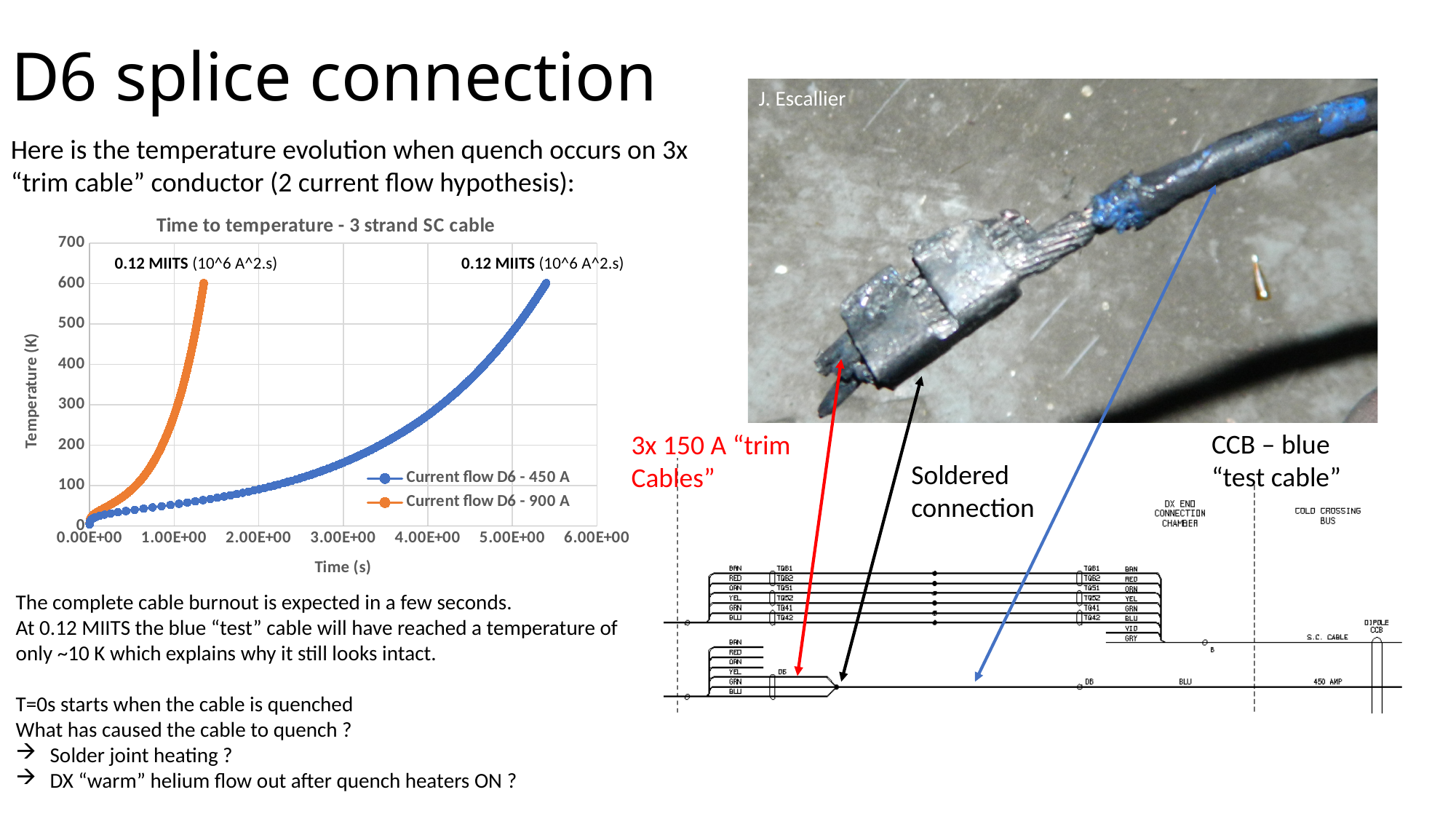
What is the title of the chart? Time to temperature - 3 strand SC cable At a time of 1.00E+00 s, is the temperature for Current flow D6 - 450 A greater or less than 100 K? less At a time of 1.00E+00 s, is the temperature for Current flow D6 - 900 A greater or less than 200 K? greater What are the two series named in the chart legend? Current flow D6 - 450 A and Current flow D6 - 900 A At a time of 5.00E+00 s, is the temperature for Current flow D6 - 450 A greater or less than 400 K? greater What kind of chart is shown on the slide? line chart Which series reaches 600 K in less time, Current flow D6 - 450 A or Current flow D6 - 900 A? Current flow D6 - 900 A How many series does the chart legend list? 2 Which series is plotted in orange? Current flow D6 - 900 A Which series rises more steeply with time? Current flow D6 - 900 A Do the temperature values rise or fall as time increases along the x axis? rise